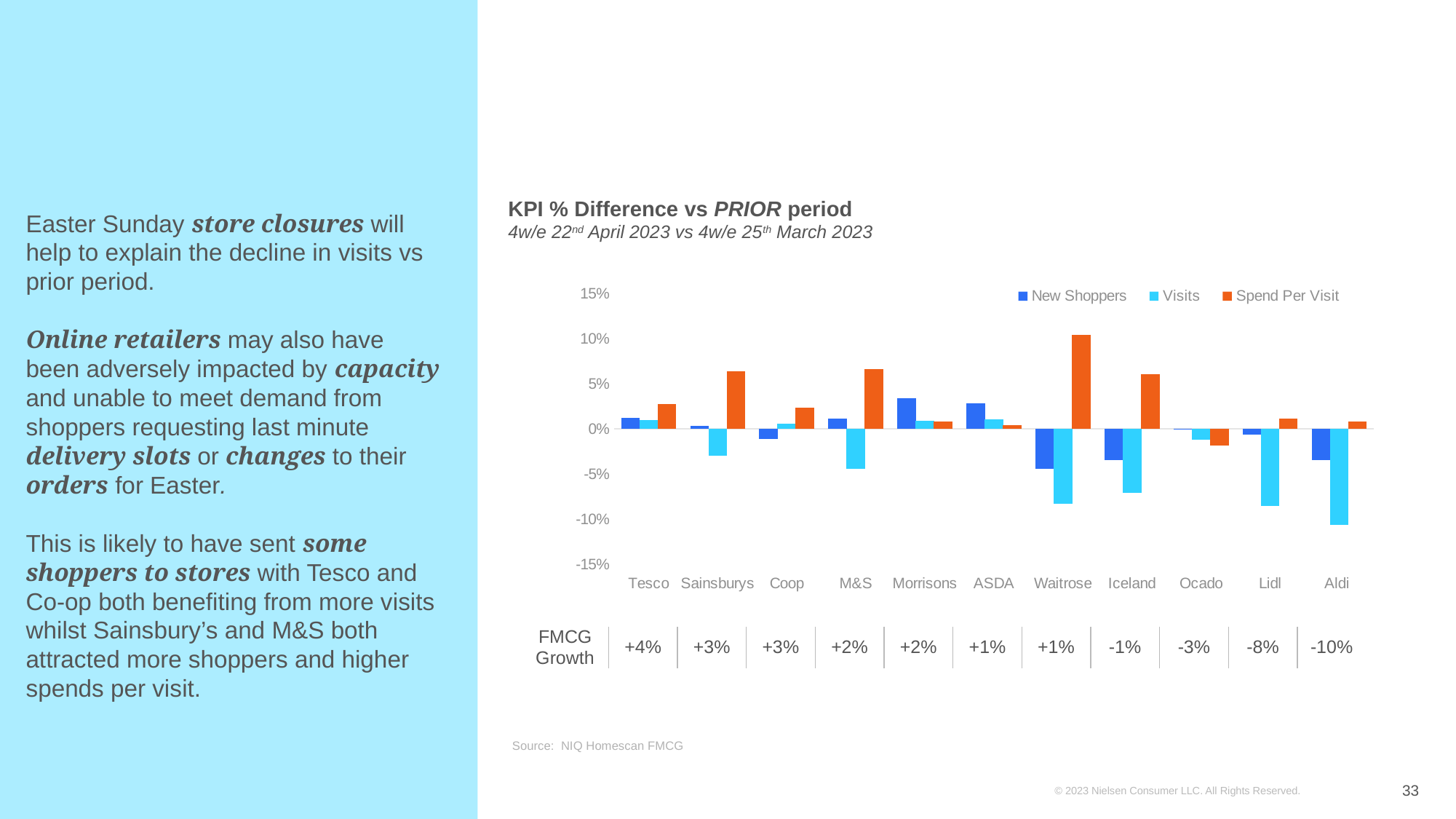
How many retailers are shown along the x axis of the chart? 11 Which retailer has the highest Spend Per Visit value in the chart? Waitrose Is the Spend Per Visit value for Waitrose greater or less than 5%? greater What is the FMCG Growth figure shown for Aldi below the chart? -10% Which is larger, the Spend Per Visit value for Waitrose or for Tesco? Waitrose How many series does the chart legend list? 3 What kind of chart is shown on the slide? bar chart Is the Visits value for Lidl greater or less than -5%? less Is the Spend Per Visit value for M&S greater or less than 5%? greater Which retailer has the lowest Visits value in the chart? Aldi What is the title of the chart? KPI % Difference vs PRIOR period What is the FMCG Growth figure shown for Tesco below the chart? +4%